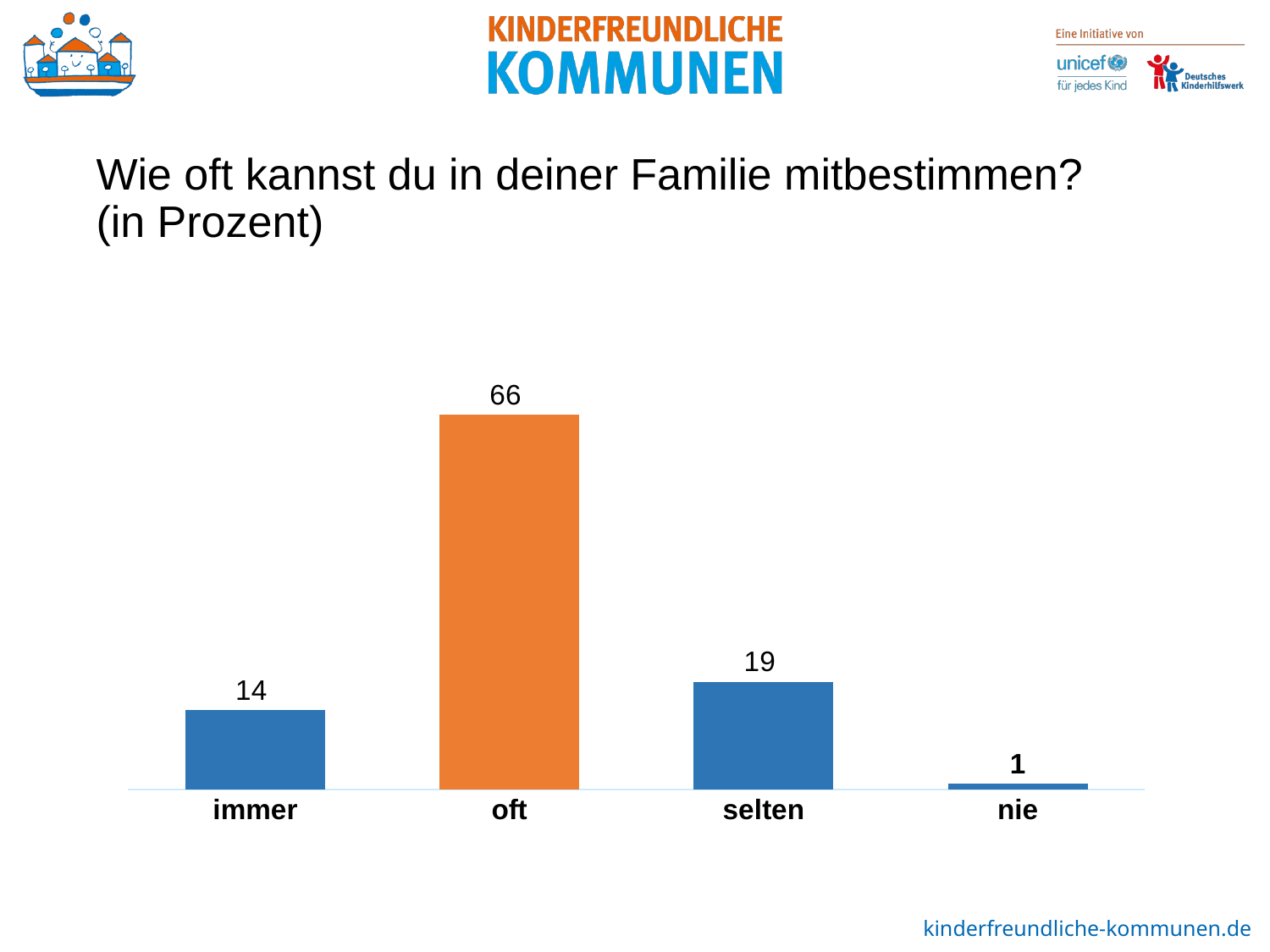
What is the value for "immer"? 14 What is the difference between the values for "oft" and "selten"? 47 Which bar is coloured orange rather than blue? oft Which is larger, the value for "immer" or the value for "selten"? selten How many categories are shown in the chart? 4 What kind of chart is shown on the slide? bar chart Which category has the highest value? oft What is the difference between the values for "selten" and "immer"? 5 What is the value for "nie"? 1 Which category has the lowest value? nie What is the value for "selten"? 19 What is the value for "oft"? 66